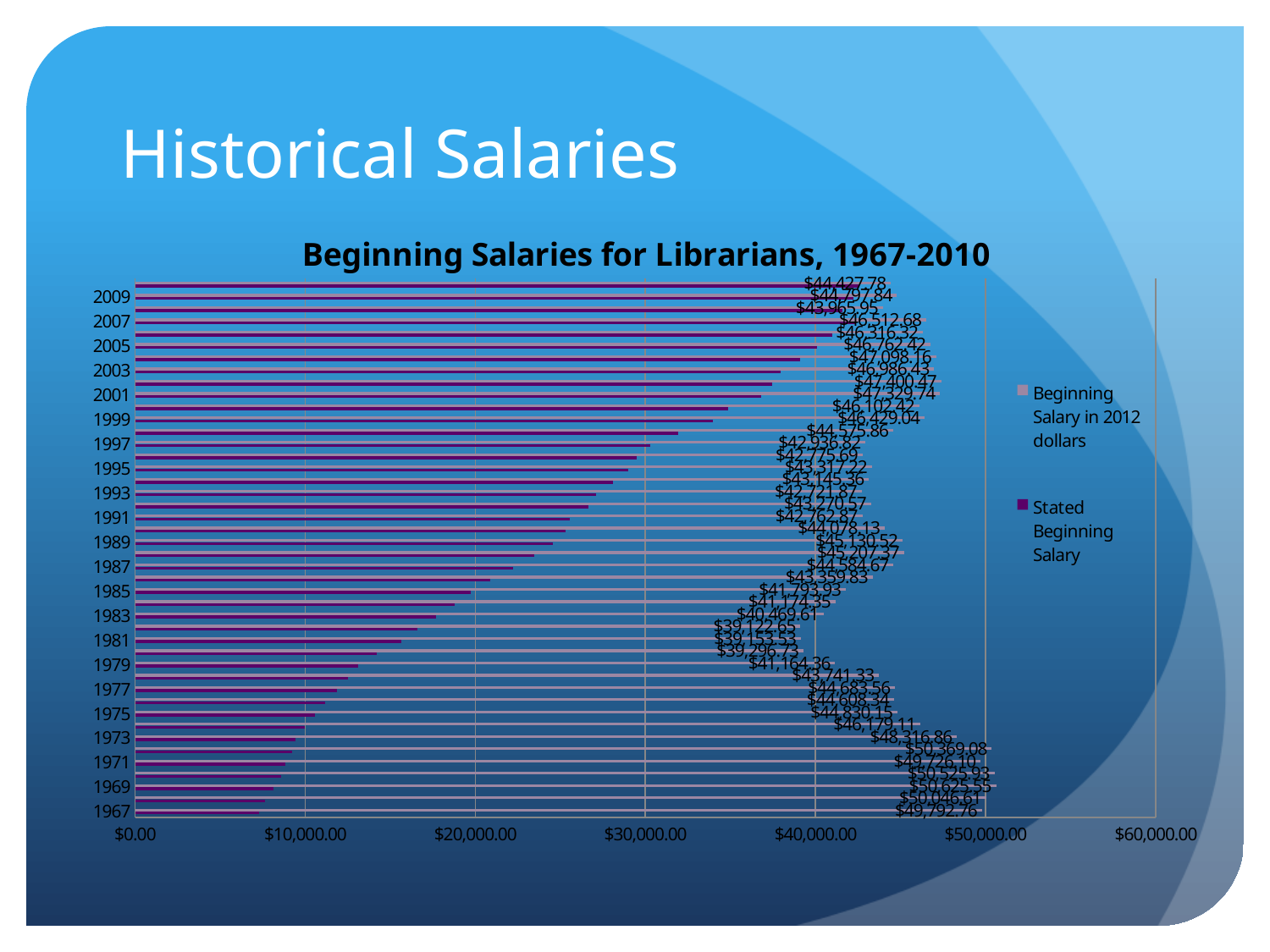
How many series does the legend list? 2 Is the Stated Beginning Salary for 2001 greater or less than $40,000.00? less Is the Stated Beginning Salary for 1981 greater or less than $20,000.00? less What are the two series named in the legend? Beginning Salary in 2012 dollars; Stated Beginning Salary Is the Stated Beginning Salary for 1991 greater or less than $20,000.00? greater What is the title of the chart? Beginning Salaries for Librarians, 1967-2010 What is the Beginning Salary in 2012 dollars for 1967? $49,792.76 Does the Stated Beginning Salary rise or fall from 1967 to 2009? rise Which year has the larger Stated Beginning Salary, 1967 or 2009? 2009 What kind of chart is shown on the slide? bar chart Which year has the larger Beginning Salary in 2012 dollars, 1967 or 1981? 1967